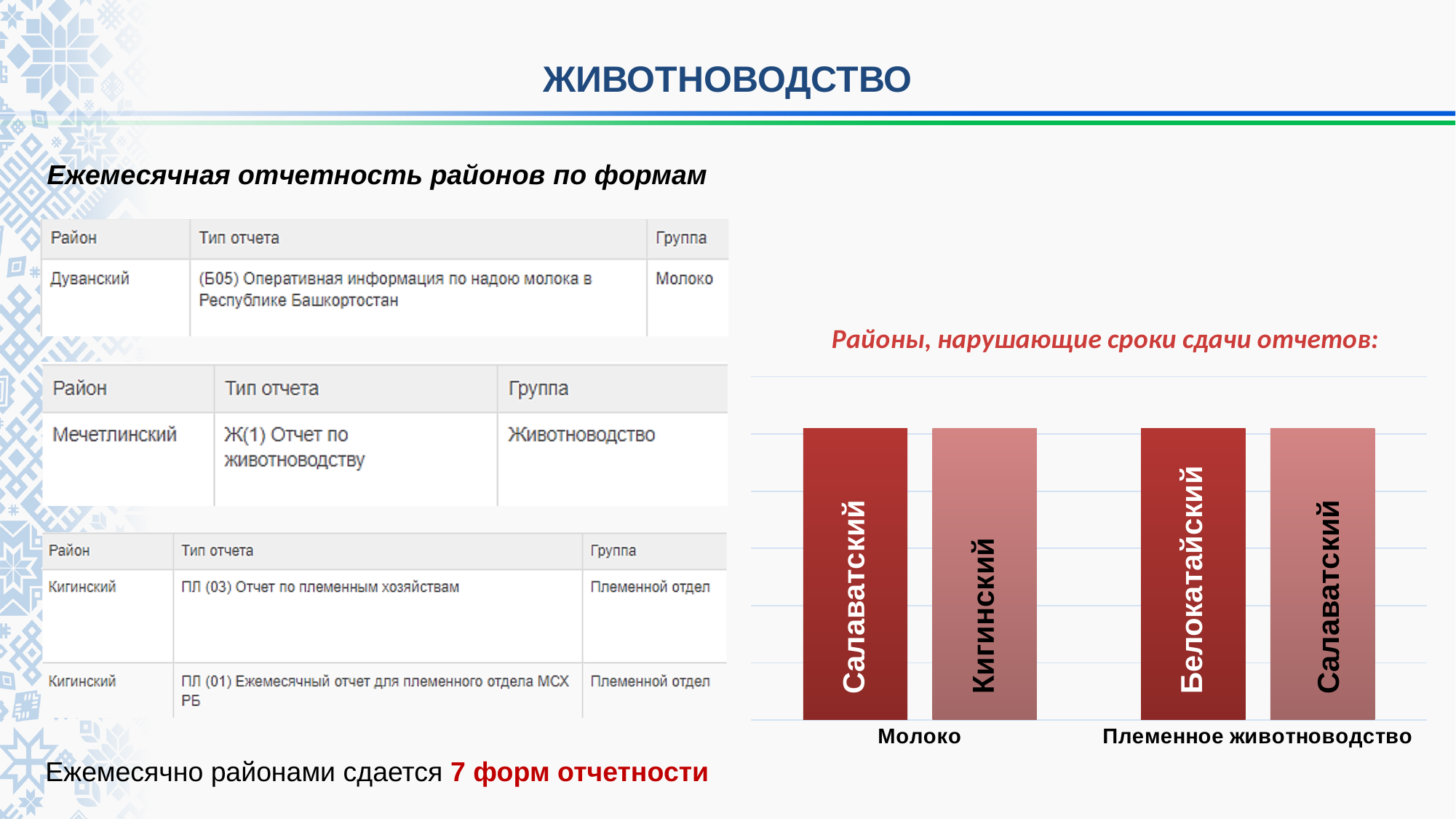
Which district is named on the first bar in the «Племенное животноводство» category? Белокатайский How many categories are shown along the x axis of the bar chart? 2 How many bars are in the «Молоко» category of the bar chart? 2 Which district appears in both categories of the bar chart? Салаватский What kind of chart is shown under the heading «Районы, нарушающие сроки сдачи отчетов»? Bar chart Which districts are named on the bars in the «Молоко» category? Салаватский, Кигинский What is the title of the bar chart on the right of the slide? Районы, нарушающие сроки сдачи отчетов: How many bars are plotted in the bar chart in total? 4 What are the two category labels on the x axis of the bar chart? Молоко, Племенное животноводство Which districts are named on the bars in the «Племенное животноводство» category? Белокатайский, Салаватский